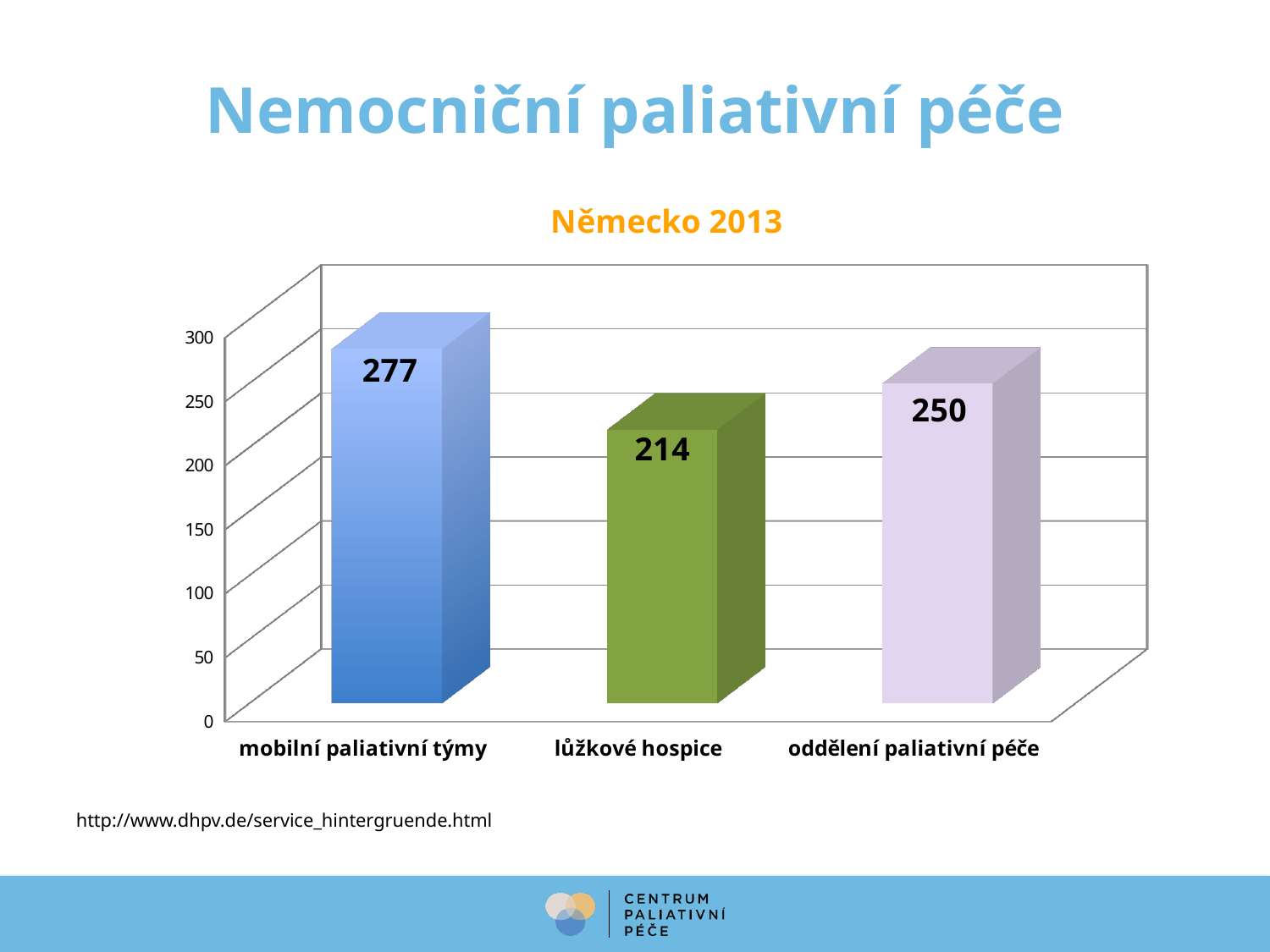
Which category has the highest value? mobilní paliativní týmy Which is larger, the value for oddělení paliativní péče or the value for lůžkové hospice? oddělení paliativní péče What is the difference between the values for oddělení paliativní péče and lůžkové hospice? 36 Is the value for lůžkové hospice greater or less than 250? less What is the value for oddělení paliativní péče? 250 What is the title of the chart? Německo 2013 How many categories are shown in the chart? 3 What kind of chart is shown on the slide? bar chart What is the difference between the values for mobilní paliativní týmy and lůžkové hospice? 63 What is the value for mobilní paliativní týmy? 277 What is the value for lůžkové hospice? 214 Which category has the lowest value? lůžkové hospice